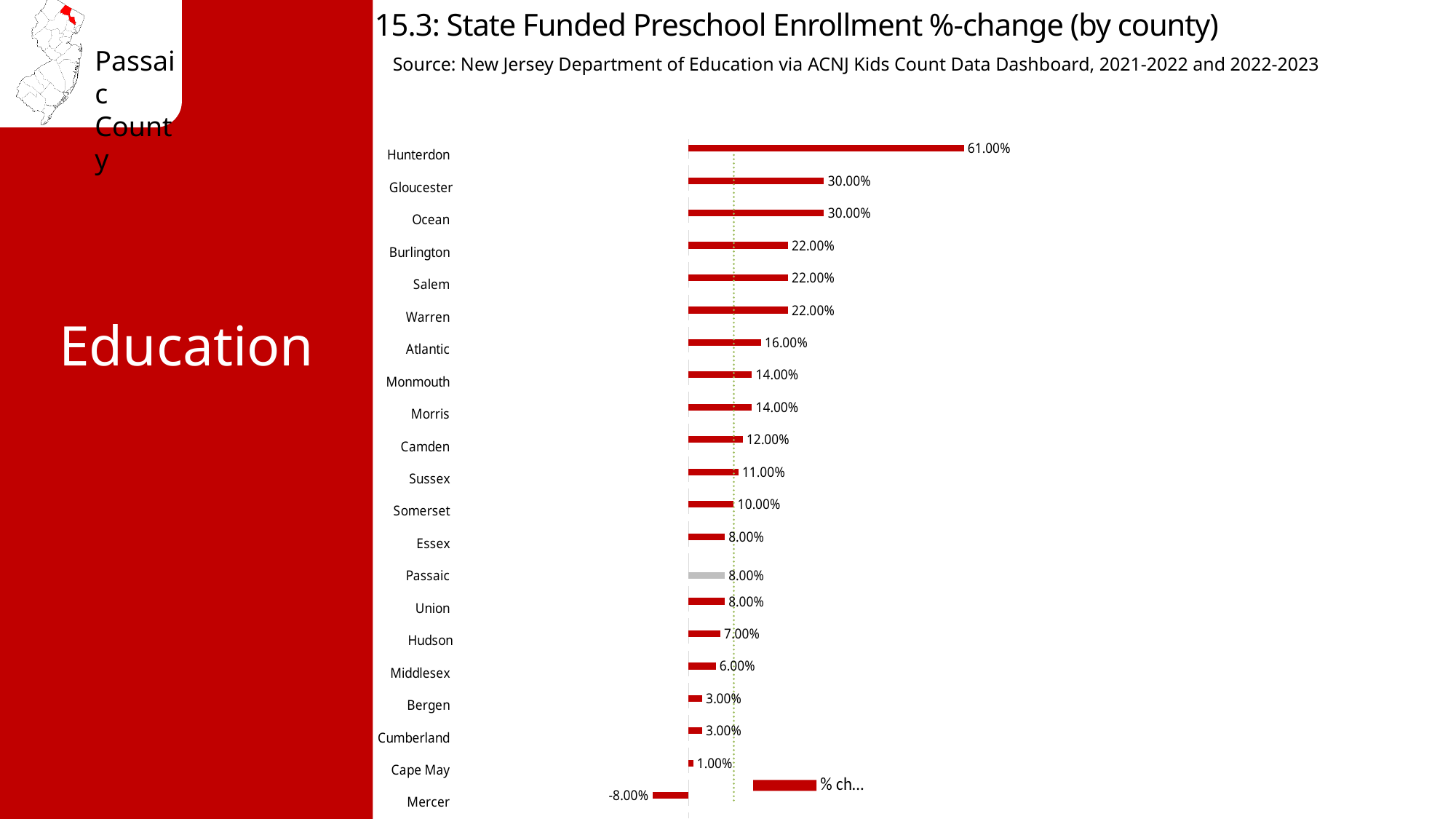
What is the state funded preschool enrollment %-change for Hunterdon? 61.00% Which county has the highest %-change in state funded preschool enrollment? Hunterdon Which county has the lowest %-change in state funded preschool enrollment? Mercer What is the difference between the %-change for Passaic and Mercer? 16.00% Which has a larger %-change, Burlington or Camden? Burlington What is the %-change value shown for Atlantic? 16.00% What is the %-change value shown for Passaic? 8.00% How many counties are shown in the chart? 21 What is the %-change value shown for Mercer? -8.00% What is the difference between the %-change for Hunterdon and Gloucester? 31.00% What kind of chart is used on this slide? Bar chart Which county's bar is shown in grey rather than red? Passaic